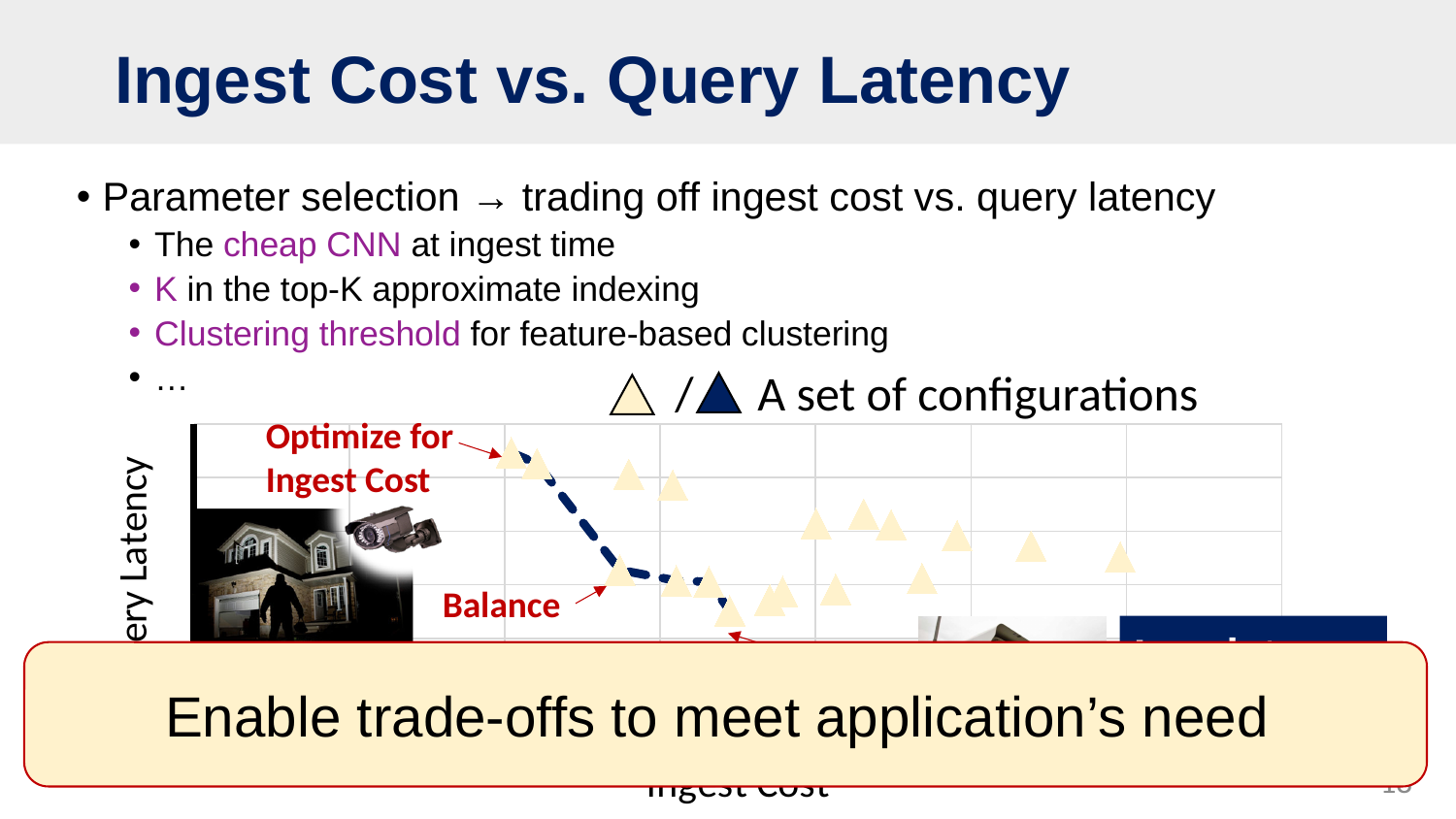
Which annotated configuration has higher query latency, "Optimize for Ingest Cost" or "Balance"? Optimize for Ingest Cost As ingest cost increases along the x axis, does query latency rise or fall? fall What kind of chart is shown on the slide? scatter chart Which annotated configuration has lower ingest cost, "Optimize for Ingest Cost" or "Balance"? Optimize for Ingest Cost According to the legend, what does a triangle marker represent? A set of configurations What is the title of the slide containing the chart? Ingest Cost vs. Query Latency